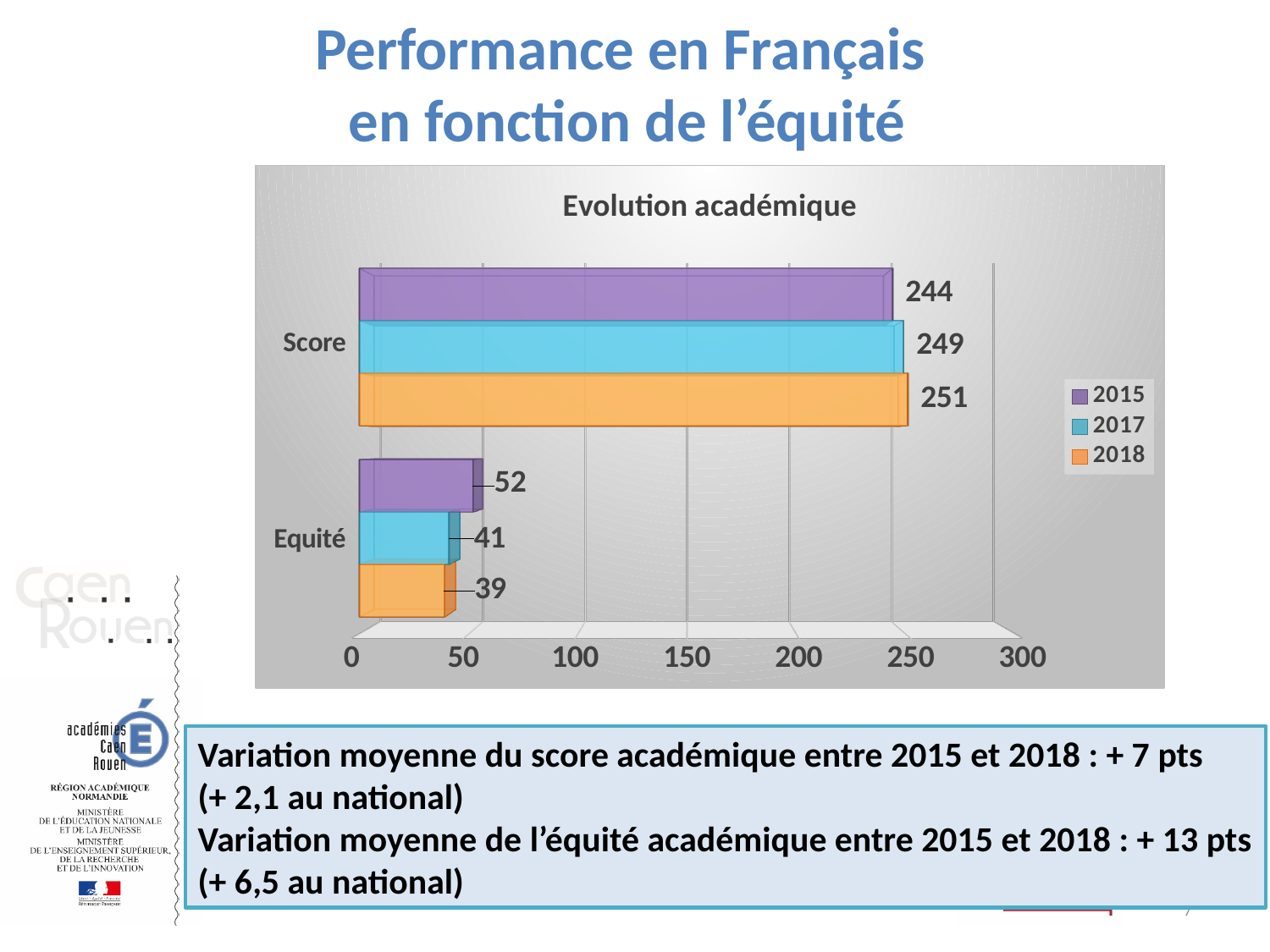
What kind of chart is shown? Bar chart What is the Score value for 2015? 244 What is the difference between the Equité values for 2015 and 2018? 13 Which is larger, the Score value for 2017 or the Score value for 2015? 2017 What is the title of the chart? Evolution académique What is the difference between the Score values for 2018 and 2015? 7 What is the Score value for 2018? 251 What is the Equité value for 2015? 52 Which year has the highest Score value? 2018 Which year has the lowest Equité value? 2018 What is the Equité value for 2017? 41 How many series does the legend list? 3